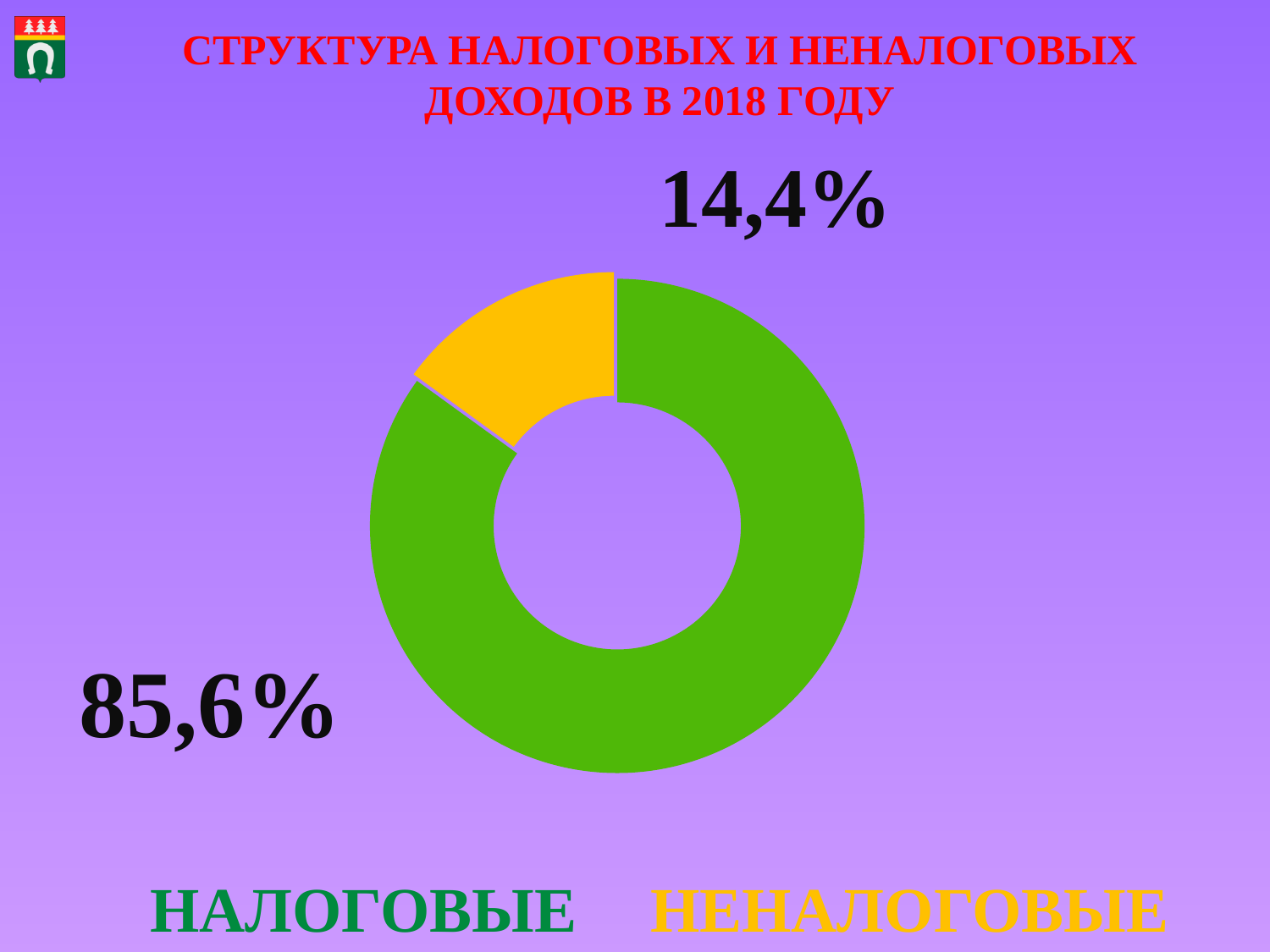
What share of revenues is НАЛОГОВЫЕ (tax revenues)? 85,6% What kind of chart is shown on the slide? Doughnut (pie) chart What is the total of the two shares shown on the chart? 100% Which category has the largest share of the chart? НАЛОГОВЫЕ Which category has the smallest share of the chart? НЕНАЛОГОВЫЕ By how many percentage points does the НАЛОГОВЫЕ share exceed the НЕНАЛОГОВЫЕ share? 71,2 What colour represents НЕНАЛОГОВЫЕ on the chart? Yellow What year does the chart title refer to? 2018 How many categories does the chart show? 2 What share of revenues is НЕНАЛОГОВЫЕ (non-tax revenues)? 14,4% Which is larger, the share of НАЛОГОВЫЕ or НЕНАЛОГОВЫЕ? НАЛОГОВЫЕ